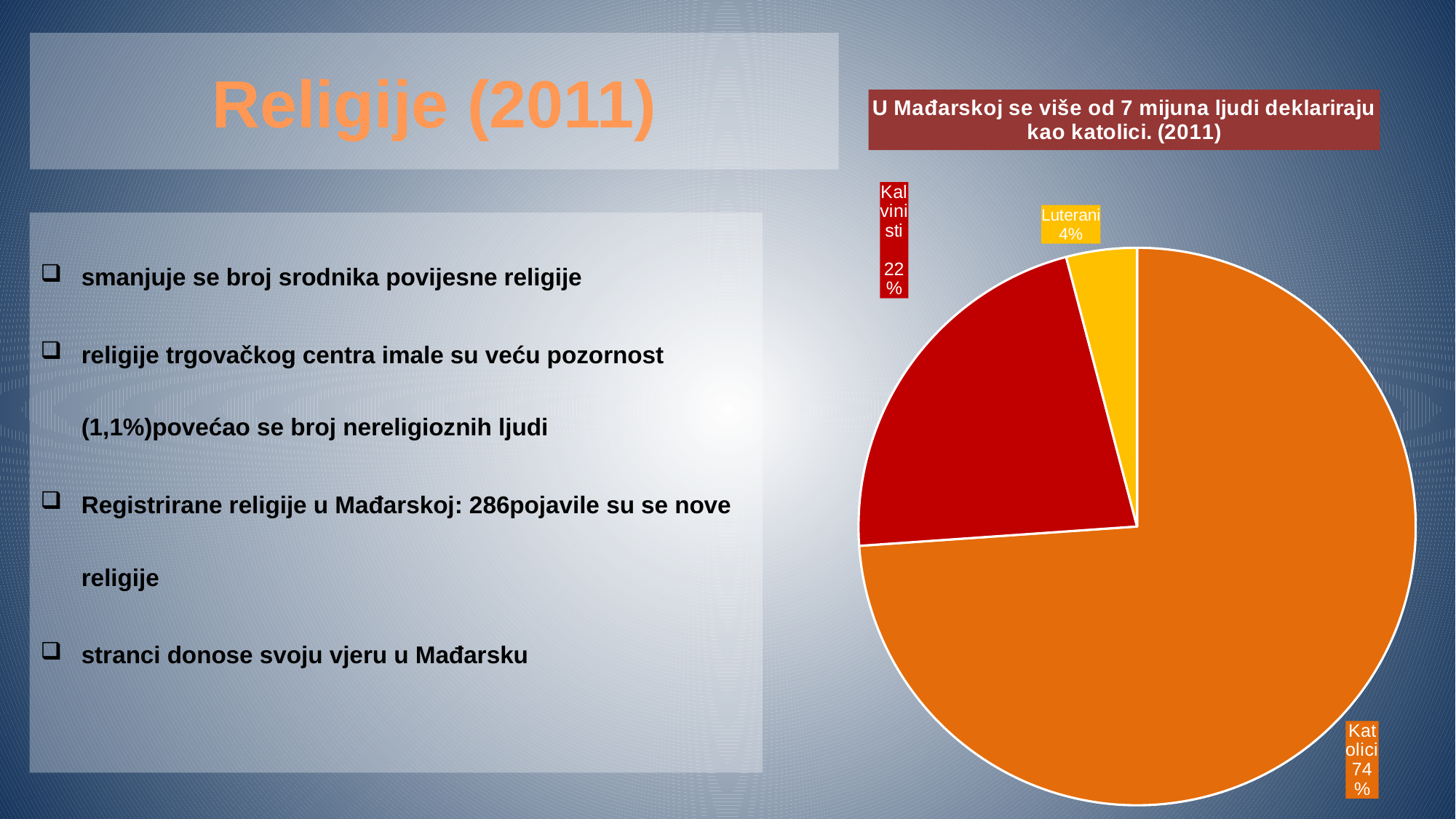
What is the difference in percentage points between the Katolici and Kalvinisti slices? 52 What share of the pie does Kalvinisti have? 22% What is the title of the pie chart? U Mađarskoj se više od 7 mijuna ljudi deklariraju kao katolici. (2011) What colour is the Katolici slice of the pie chart? orange How many slices does the pie chart have? 3 Which slice of the pie chart is the largest? Katolici What kind of chart is shown on the slide? pie chart Which is larger, the Kalvinisti slice or the Luterani slice? Kalvinisti What is the difference in percentage points between the Kalvinisti and Luterani slices? 18 What share of the pie does Luterani have? 4% What share of the pie does Katolici have? 74% Which slice of the pie chart is the smallest? Luterani